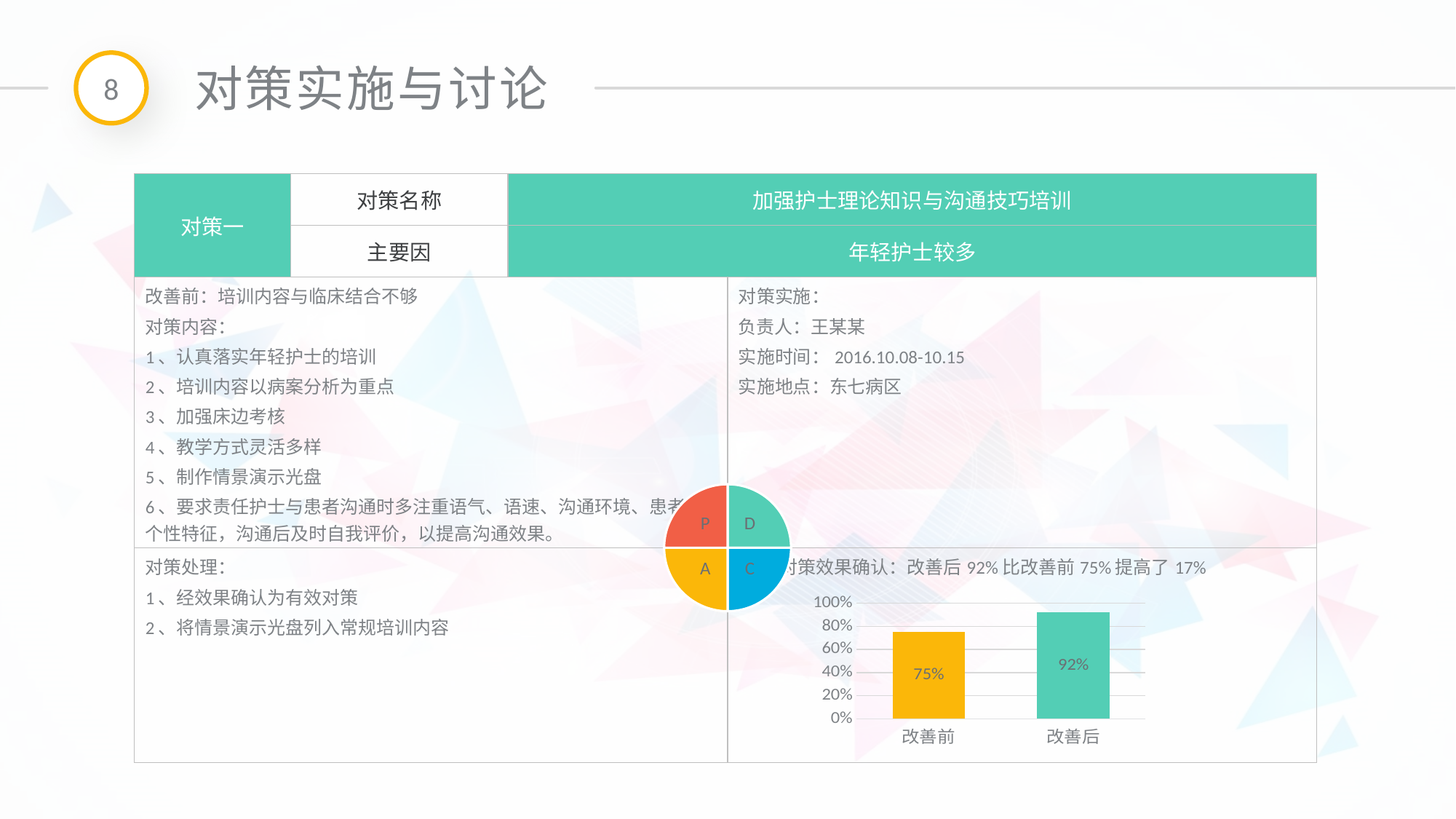
What is the maximum value shown on the y axis of the bar chart? 100% Is the value for 改善后 greater or less than 80% in the bar chart? greater Which category has the lower value in the bar chart? 改善前 How many categories are shown in the bar chart? 2 What is the difference between the 改善后 and 改善前 values in the bar chart? 17% What kind of chart is shown at the bottom right of the slide? bar chart Is the value for 改善前 greater or less than 80% in the bar chart? less What is the value for 改善后 in the bar chart? 92% What is the value for 改善前 in the bar chart? 75% Which category has the higher value in the bar chart? 改善后 What colour is the 改善后 bar in the bar chart? green Do the values rise or fall from 改善前 to 改善后 in the bar chart? rise